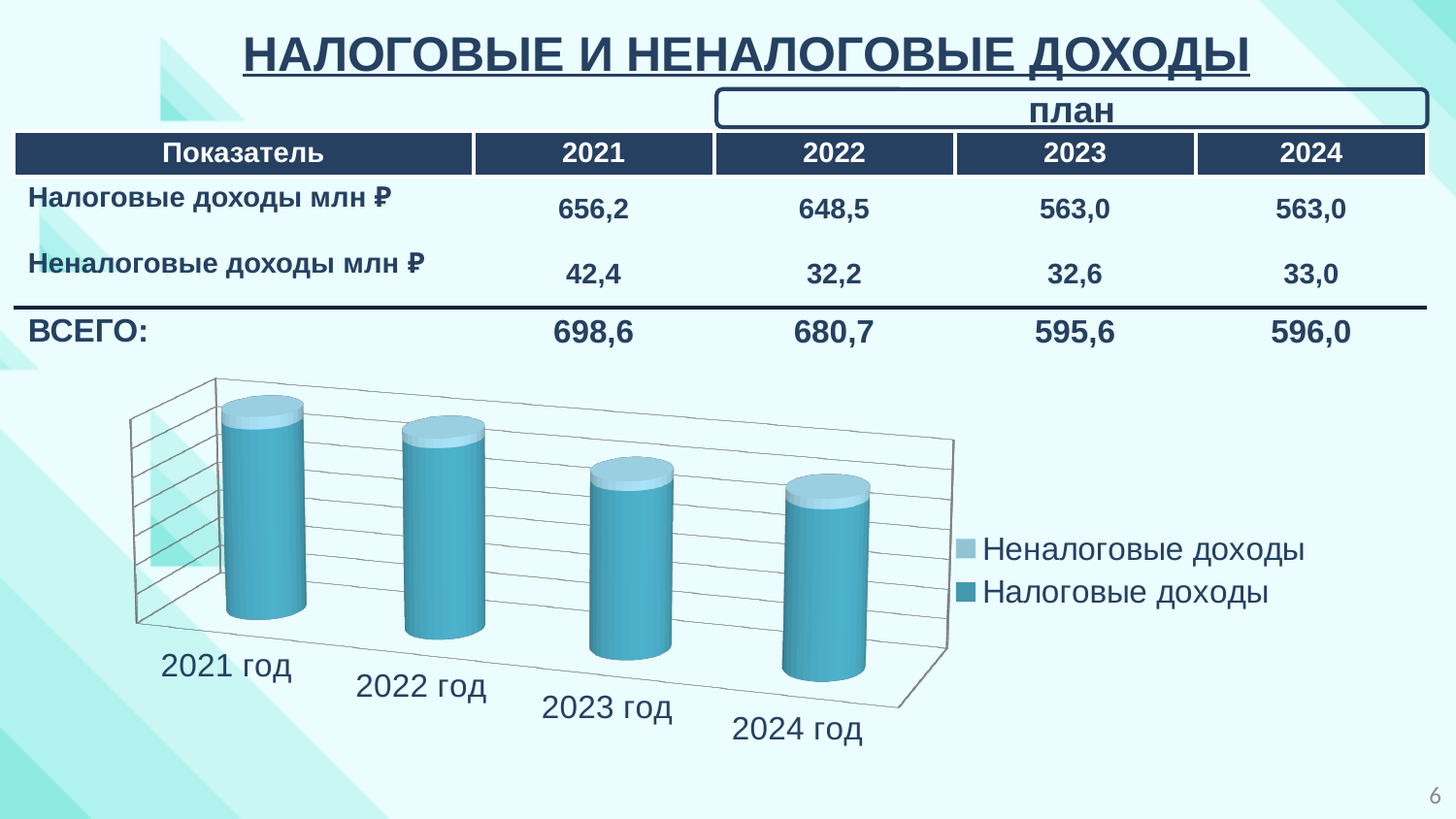
Which bar is taller, 2021 год or 2023 год? 2021 год What is the total (ВСЕГО) of the stacked bar for 2023 according to the slide? 595,6 According to the slide, what is the value of Неналоговые доходы for 2024? 33,0 What kind of chart is shown on the slide? Stacked bar chart Do the stacked bar heights rise or fall from 2021 to 2024? Fall According to the slide, what is the value of Налоговые доходы for 2021? 656,2 By how much do Налоговые доходы in 2021 exceed Налоговые доходы in 2023? 93,2 Which series is shown as the lighter blue top segment of each bar? Неналоговые доходы What is the difference between Неналоговые доходы in 2021 and 2022? 10,2 Which year has the tallest stacked bar in the chart? 2021 год How many series does the chart legend list? 2 How many year categories are shown on the x axis of the chart? 4